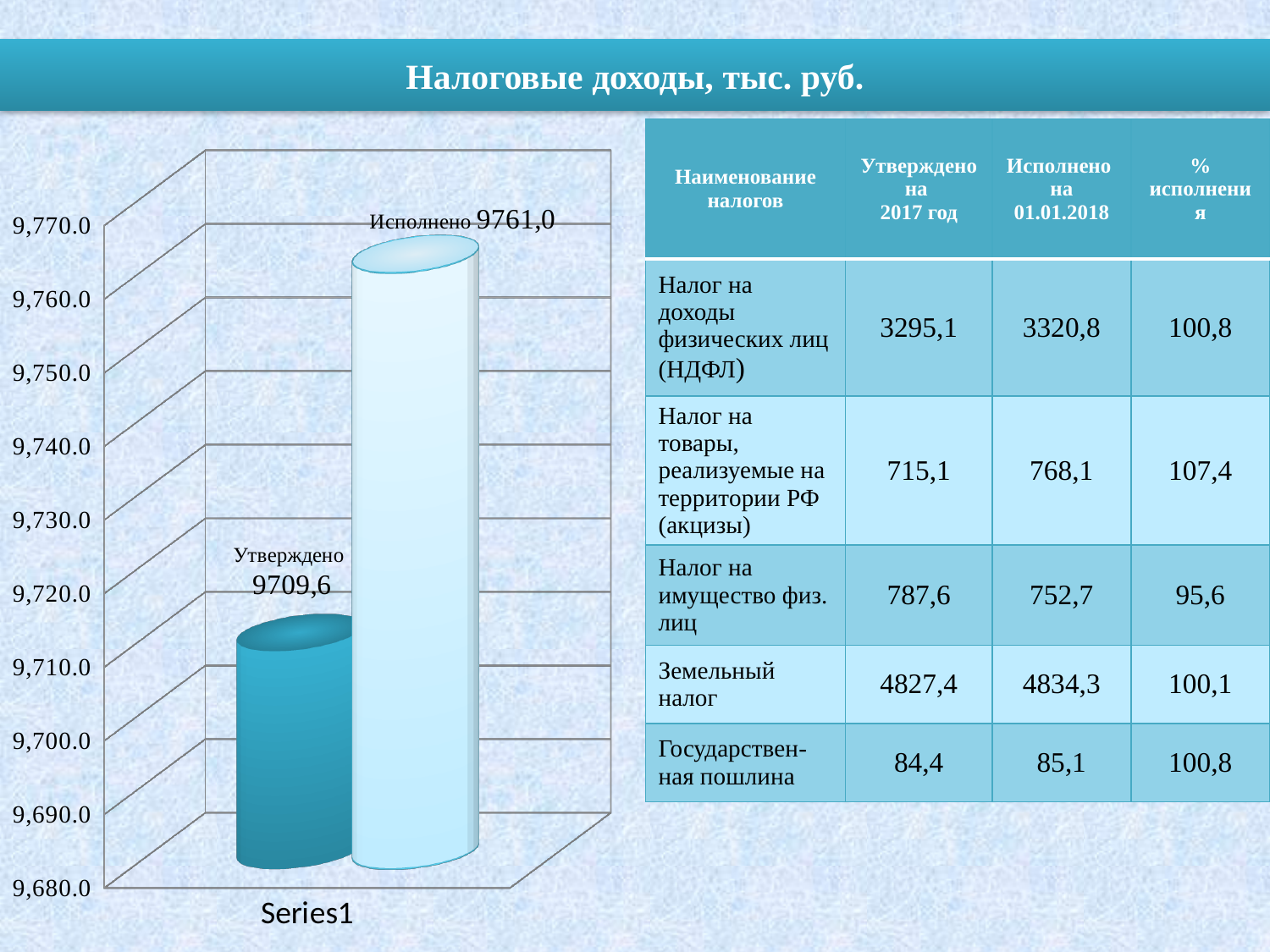
What is the value of the Утверждено bar in the chart? 9709,6 Is the value for Утверждено greater or less than 9,720.0? less What is the difference between the Исполнено and Утверждено values in the chart? 51,4 Is the Утверждено value larger or smaller than the Исполнено value in the chart? smaller How many bars are plotted in the chart? 2 What kind of chart is shown on the slide? bar chart Which bar in the chart is higher, Утверждено or Исполнено? Исполнено Is the value for Исполнено greater or less than 9,750.0? greater What is the value of the Исполнено bar in the chart? 9761,0 What label appears on the horizontal axis of the chart? Series1 Which bar in the chart is the lowest? Утверждено What is the title of the slide above the chart? Налоговые доходы, тыс. руб.